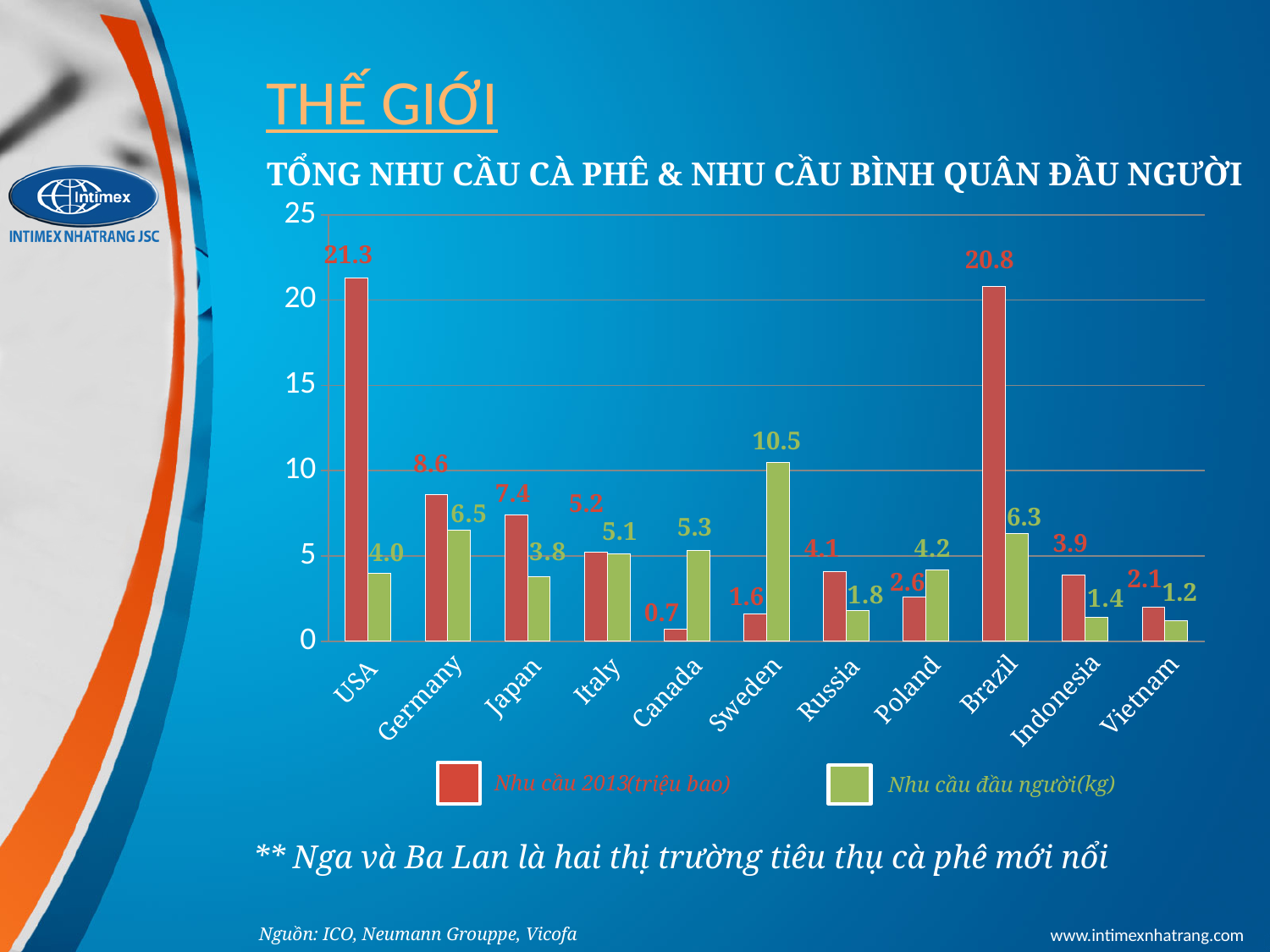
What is the value of Nhu cầu đầu người(kg) for Vietnam? 1.2 Which is larger for Germany: Nhu cầu 2013(triệu bao) or Nhu cầu đầu người(kg)? Nhu cầu 2013(triệu bao) What is the value of Nhu cầu 2013(triệu bao) for Brazil? 20.8 What is the value of Nhu cầu 2013(triệu bao) for USA? 21.3 What is the value of Nhu cầu đầu người(kg) for Sweden? 10.5 Which country has the highest value for Nhu cầu đầu người(kg)? Sweden What kind of chart is shown on the slide? Bar chart What is the difference between the Nhu cầu 2013(triệu bao) values for USA and Brazil? 0.5 What colour are the bars for Nhu cầu đầu người(kg)? Green How many series does the legend list? 2 How many countries are shown on the x axis? 11 Which country has the lowest value for Nhu cầu 2013(triệu bao)? Canada